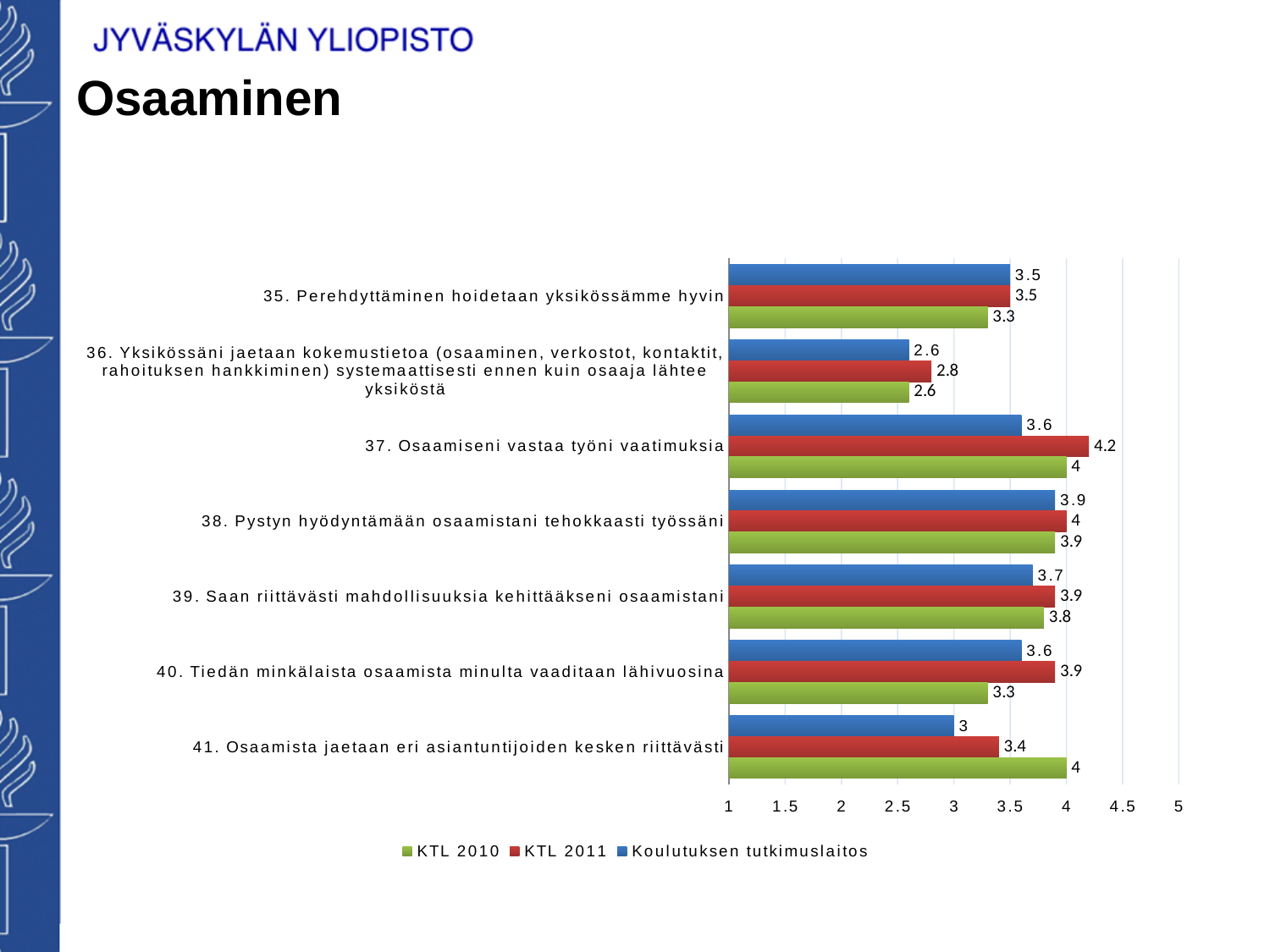
What type of chart is shown on the slide? Bar chart What is the Koulutuksen tutkimuslaitos value for item 41, "Osaamista jaetaan eri asiantuntijoiden kesken riittävästi"? 3 How many items (categories) are shown in the chart? 7 How many series does the legend list? 3 What is the KTL 2011 value for item 37, "Osaamiseni vastaa työni vaatimuksia"? 4.2 What is the difference between the KTL 2010 and Koulutuksen tutkimuslaitos values for item 41? 1 For item 40, which is larger: the KTL 2011 value or the KTL 2010 value? KTL 2011 Which series is shown in red in the chart? KTL 2011 Which item has the highest KTL 2011 value? 37. Osaamiseni vastaa työni vaatimuksia Which item has the lowest KTL 2011 value? 36. Yksikössäni jaetaan kokemustietoa (osaaminen, verkostot, kontaktit, rahoituksen hankkiminen) systemaattisesti ennen kuin osaaja lähtee yksiköstä What is the KTL 2010 value for item 40, "Tiedän minkälaista osaamista minulta vaaditaan lähivuosina"? 3.3 Is the KTL 2011 value for item 36 greater or less than 3? less